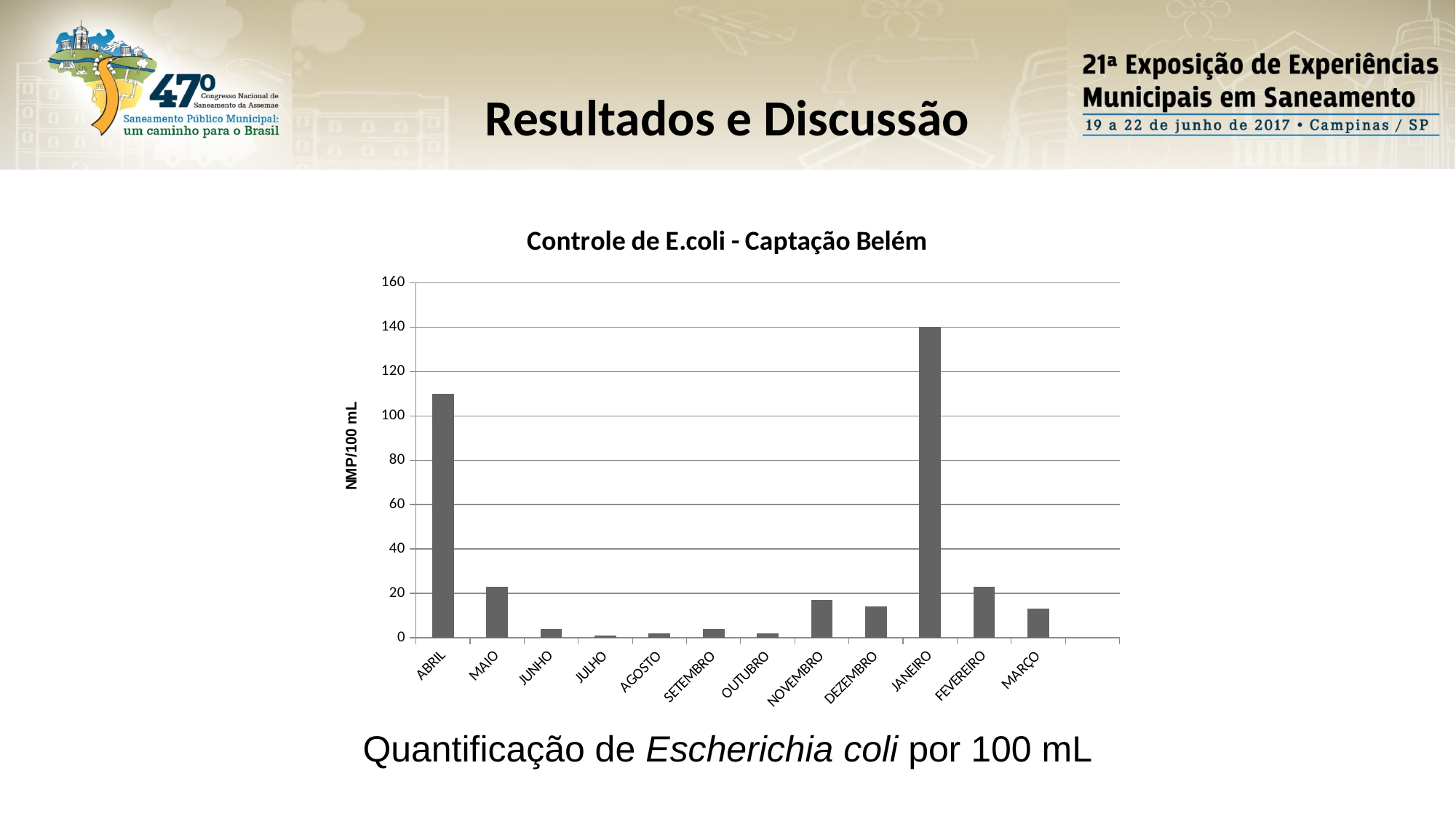
Is the value for MARÇO greater or less than 20? less What is the title of the chart? Controle de E.coli - Captação Belém Which is larger, the value for MAIO or the value for DEZEMBRO? MAIO What is the value for JANEIRO? 140 How many months are shown on the x axis of the chart? 12 Which month has the highest value in the chart? JANEIRO Which is larger, the value for ABRIL or the value for JANEIRO? JANEIRO Is the value for NOVEMBRO greater or less than 20? less Is the value for ABRIL greater or less than 100? greater What kind of chart is shown on the slide? bar chart What is the label of the vertical axis? NMP/100 mL